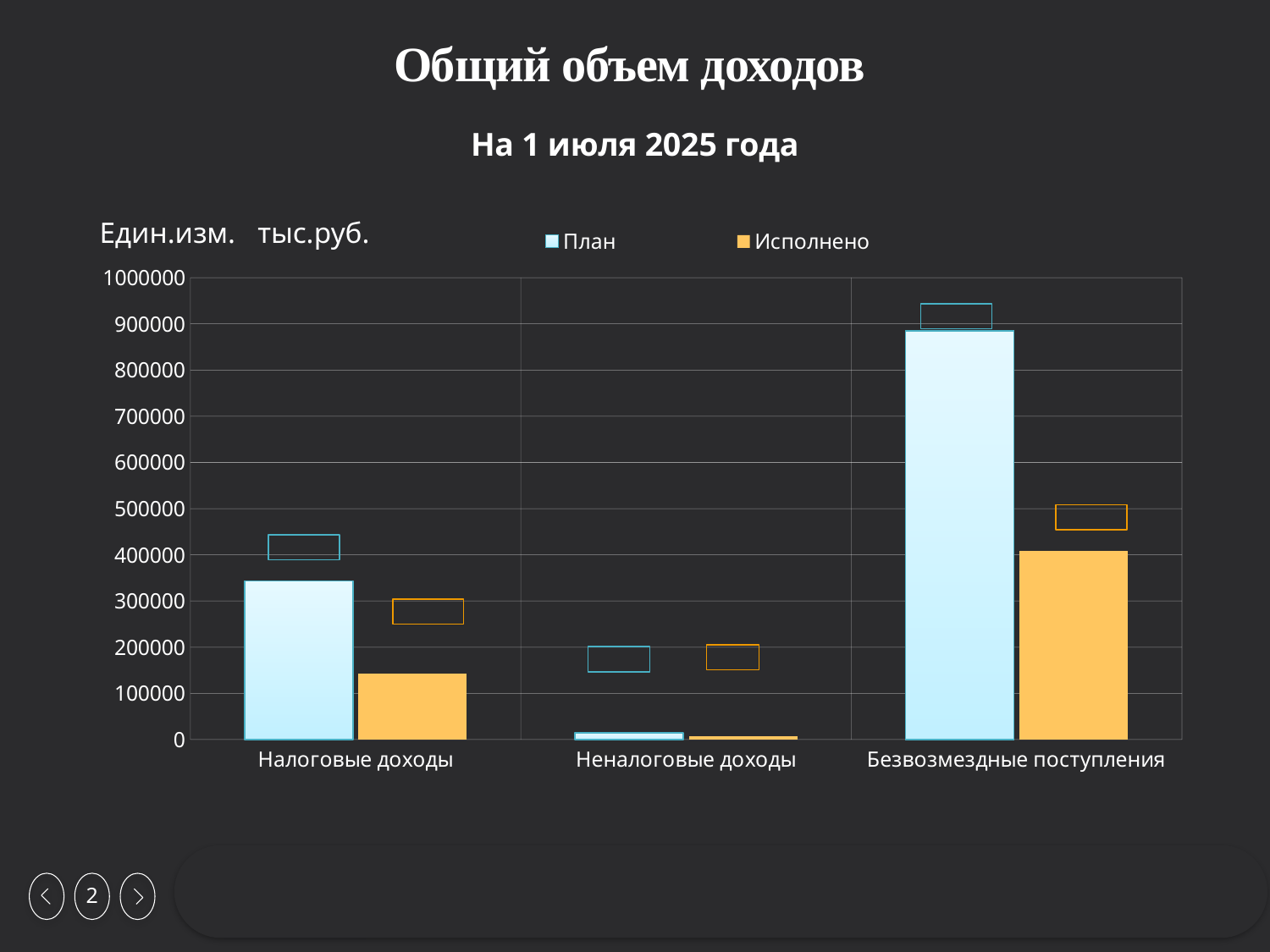
Which category has the highest value for План? Безвозмездные поступления How many series does the legend list? 2 Is the План value for Безвозмездные поступления greater or less than 800000? greater Which category has the lowest value for Исполнено? Неналоговые доходы What unit of measurement is stated for the chart? тыс.руб. How many categories are shown on the x axis? 3 Is the План value for Неналоговые доходы greater or less than 100000? less Is the Исполнено value for Безвозмездные поступления greater or less than 500000? less What kind of chart is shown on the slide? bar chart For Налоговые доходы, which is larger: План or Исполнено? План